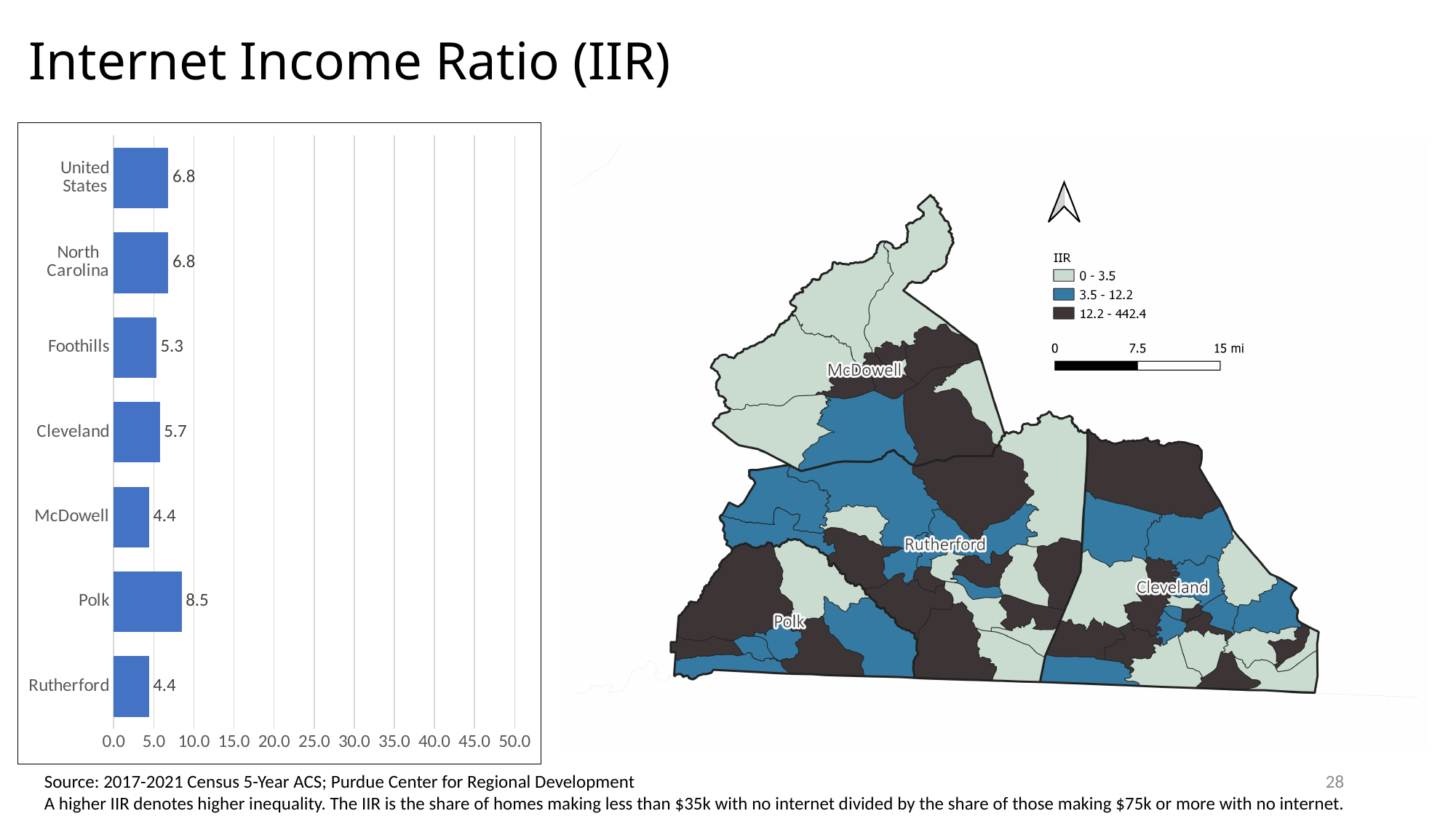
How many categories are shown in the bar chart? 7 What kind of chart is shown on the left of the slide? Bar chart What is the difference between the IIR values for Cleveland and Foothills in the bar chart? 0.4 Which category has the highest IIR value in the bar chart? Polk Is the value for Polk in the bar chart greater or less than 10.0? less What is the difference between the IIR values for Polk and Rutherford in the bar chart? 4.1 In the bar chart, which has a larger IIR value, Cleveland or McDowell? Cleveland What is the IIR value for North Carolina in the bar chart? 6.8 What is the highest value shown on the x axis of the bar chart? 50.0 What is the IIR value for Cleveland in the bar chart? 5.7 What is the IIR value for Polk in the bar chart? 8.5 What is the IIR value for Foothills in the bar chart? 5.3